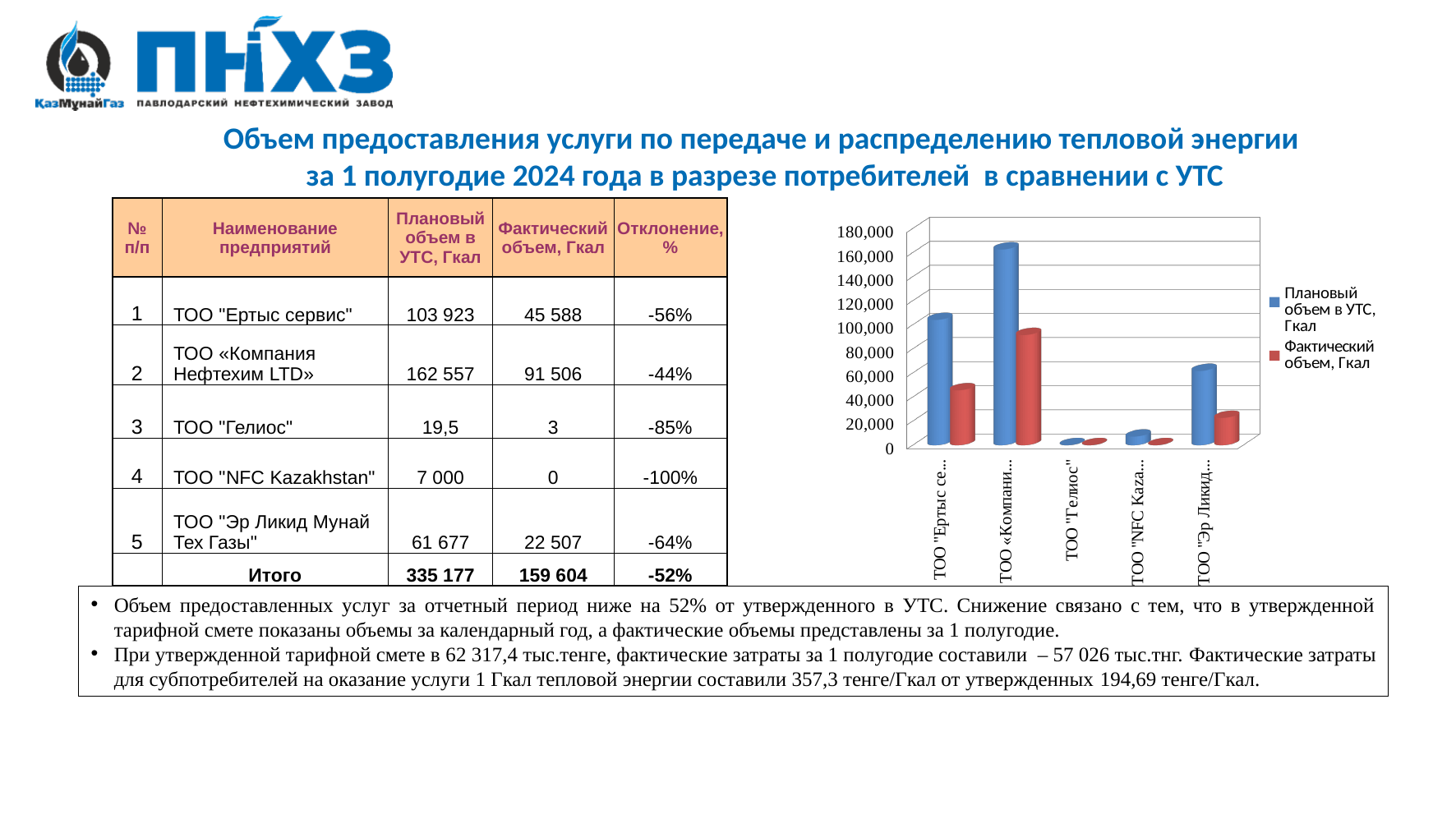
Is the planned volume (Плановый объем в УТС) for ТОО "Эр Ликид Мунай Тех Газы" greater or less than 40,000? greater For ТОО "Ертыс сервис", which is larger in the chart: the planned volume or the actual volume? planned volume Is the actual volume (Фактический объем) for ТОО «Компания Нефтехим LTD» greater or less than 100,000? less Is the actual volume (Фактический объем) for ТОО "Эр Ликид Мунай Тех Газы" greater or less than 40,000? less How many companies (categories) are plotted on the x axis of the chart? 5 What colour are the bars for the series "Фактический объем, Гкал" in the chart? red What kind of chart is shown on the slide? bar chart Which company has the lowest planned volume (Плановый объем в УТС) in the chart? ТОО "Гелиос" Which company has the highest planned volume (Плановый объем в УТС) in the chart? ТОО «Компания Нефтехим LTD» Which is larger in the chart: the planned volume for ТОО "Ертыс сервис" or the planned volume for ТОО "Эр Ликид Мунай Тех Газы"? ТОО "Ертыс сервис" How many series does the chart legend list? 2